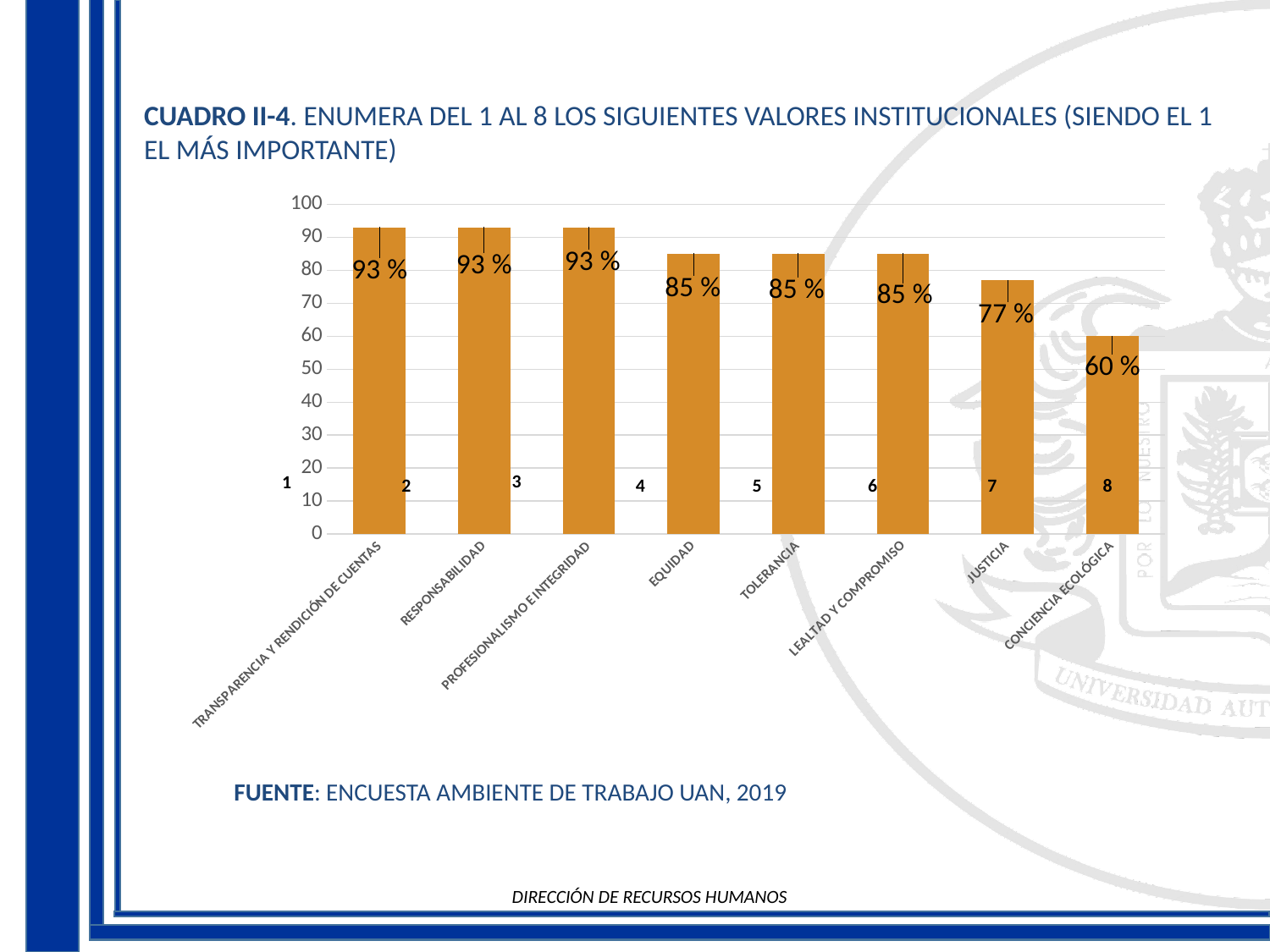
What is the value for CONCIENCIA ECOLÓGICA? 60 % How many categories are shown on the x axis? 8 What kind of chart is shown on the slide? bar chart What is the value for JUSTICIA? 77 % Which is larger, the value for PROFESIONALISMO E INTEGRIDAD or the value for LEALTAD Y COMPROMISO? PROFESIONALISMO E INTEGRIDAD What is the value for RESPONSABILIDAD? 93 % What is the difference between the values for TOLERANCIA and JUSTICIA? 8 % What is the value for EQUIDAD? 85 % What is the difference between the values for TRANSPARENCIA Y RENDICIÓN DE CUENTAS and CONCIENCIA ECOLÓGICA? 33 % Is the value for JUSTICIA greater or less than 80? less Which category has the lowest value? CONCIENCIA ECOLÓGICA Do the values rise or fall from left to right along the x axis? fall